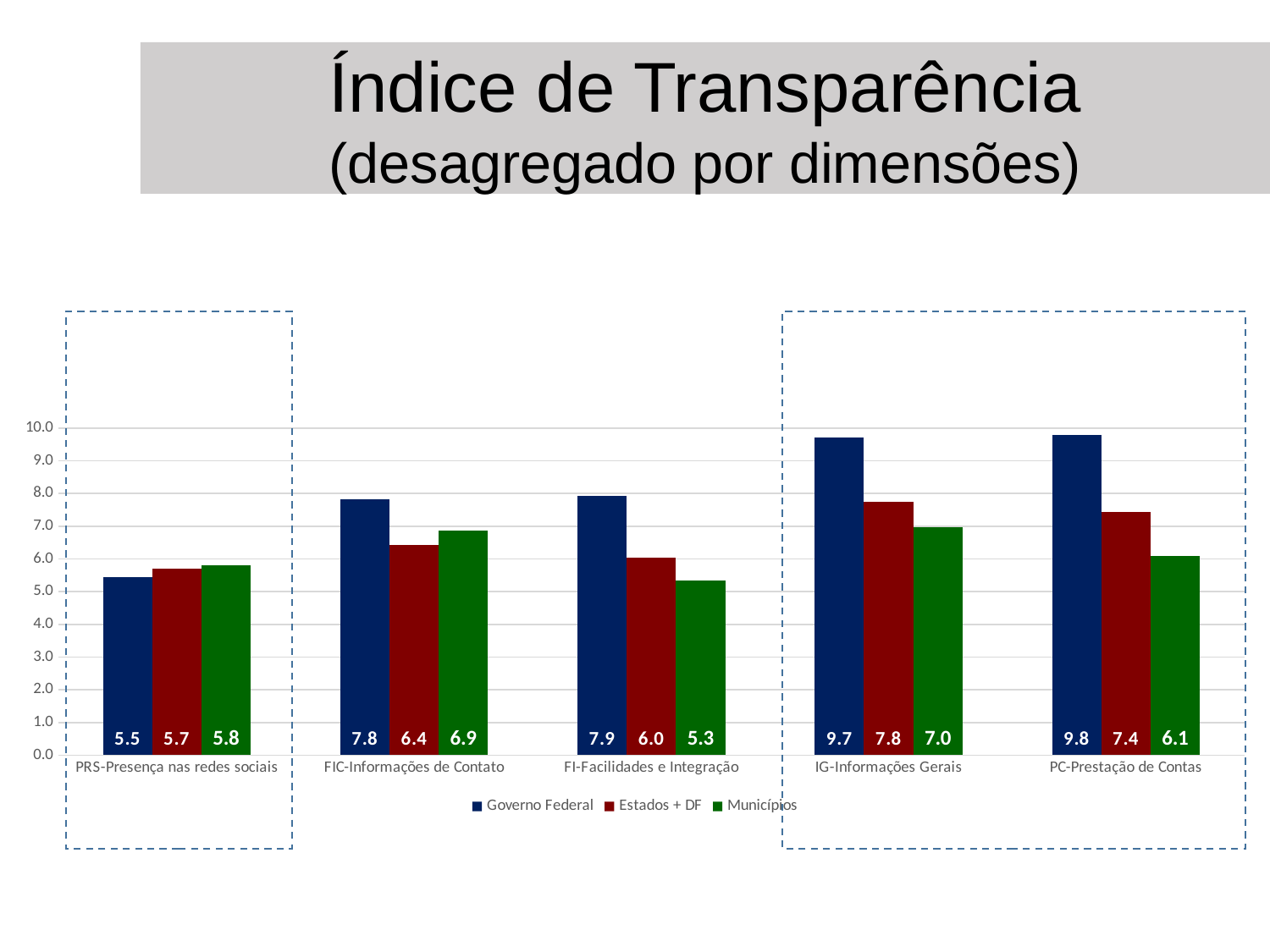
In which category is the Estados + DF value highest? IG-Informações Gerais Is the Governo Federal value for IG-Informações Gerais greater or less than 9.0? greater What is the value for Estados + DF in the PC-Prestação de Contas category? 7.4 What is the difference between the Governo Federal and Municípios values in the PC-Prestação de Contas category? 3.7 In which category is the Municípios value lowest? FI-Facilidades e Integração What is the value for Governo Federal in the IG-Informações Gerais category? 9.7 What is the value for Municípios in the FI-Facilidades e Integração category? 5.3 What kind of chart is shown on the slide? bar chart Which is larger in the PRS-Presença nas redes sociais category: Governo Federal or Municípios? Municípios How many categories are shown on the x axis? 5 In which category is the Governo Federal value lowest? PRS-Presença nas redes sociais How many series does the legend list? 3